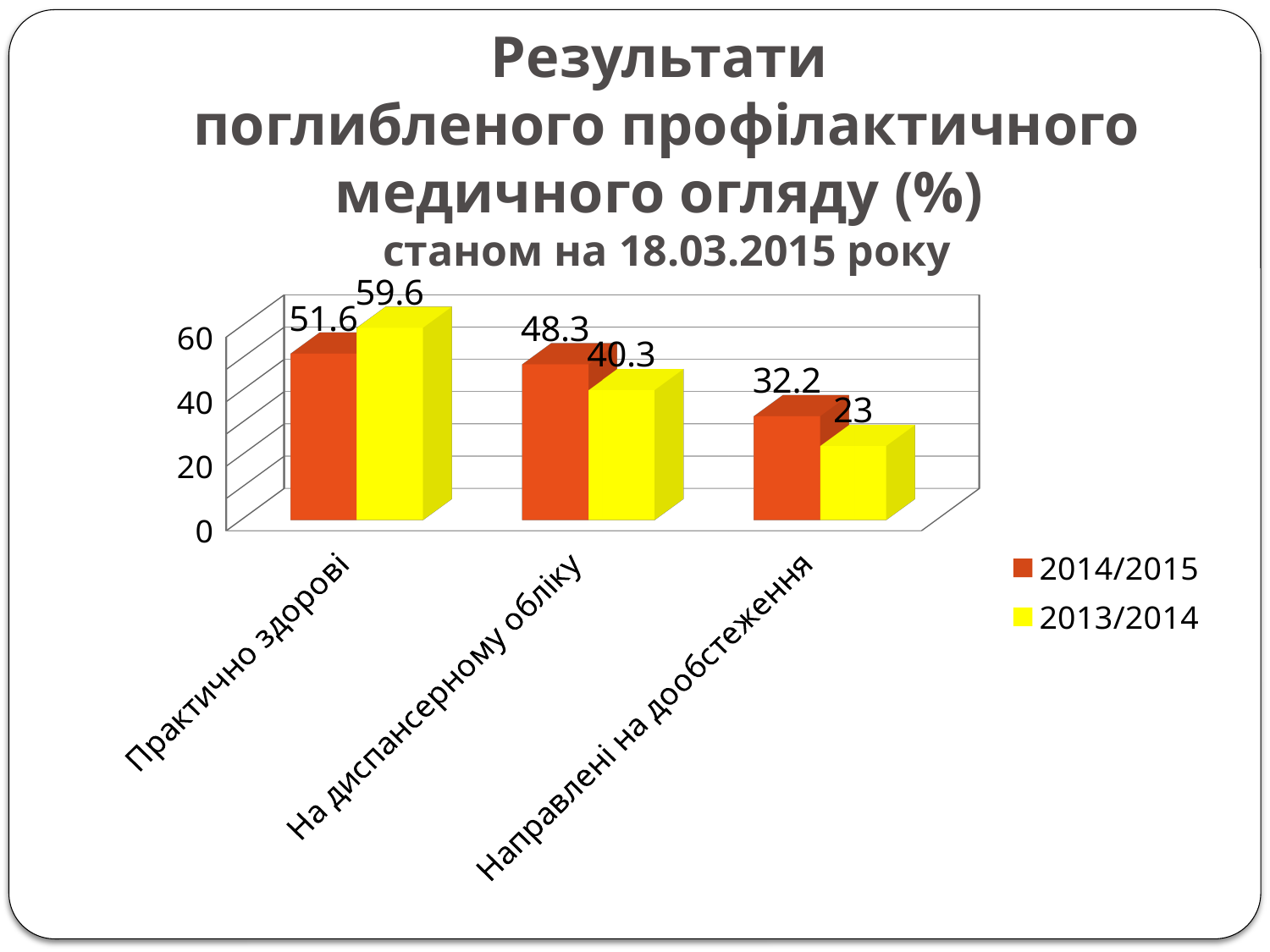
Which category has the lowest value in the 2013/2014 series? Направлені на дообстеження What kind of chart is shown on the slide? Bar chart What is the difference between the 2014/2015 and 2013/2014 values for На диспансерному обліку? 8 How many categories are shown on the x axis? 3 What is the value for Практично здорові in the 2013/2014 series? 59.6 What is the value for Практично здорові in the 2014/2015 series? 51.6 Which colour represents the 2013/2014 series? Yellow Which category has the highest value in the 2014/2015 series? Практично здорові Which is larger for Практично здорові: the 2014/2015 value or the 2013/2014 value? 2013/2014 How many series does the legend list? 2 What is the value for Направлені на дообстеження in the 2014/2015 series? 32.2 What is the value for На диспансерному обліку in the 2013/2014 series? 40.3